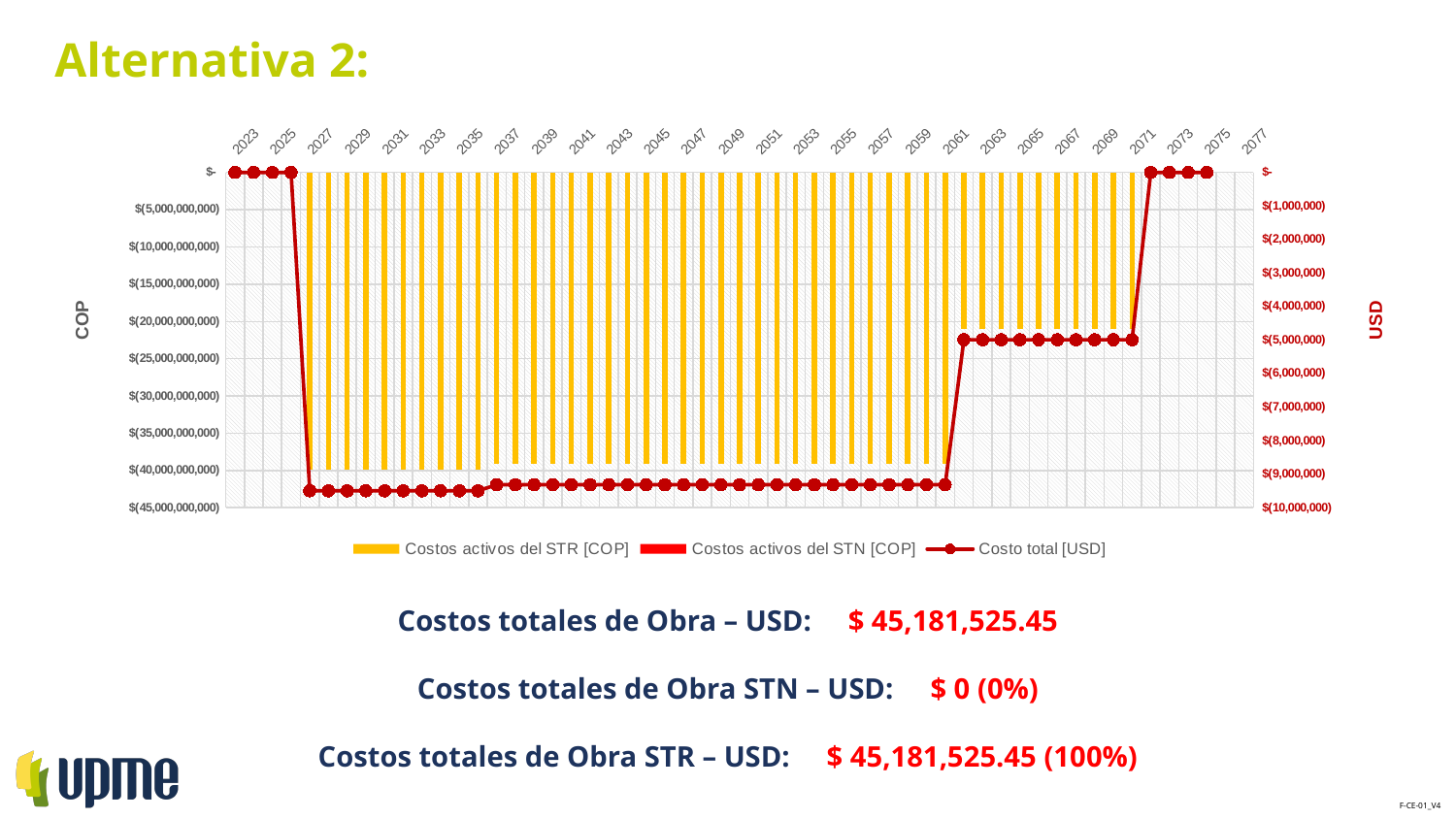
What is the title of the left vertical axis of the chart? COP What is the value of Costo total [USD] in 2023? $- Is the value of Costo total [USD] in 2065 greater or less than $(4,000,000)? less Is the value of Costo total [USD] in 2031 greater or less than $(9,000,000)? less Which series is drawn as a line with markers in the chart? Costo total [USD] Which is higher on the USD axis, the Costo total [USD] value in 2065 or in 2045? 2065 Is the value of Costos activos del STR [COP] in 2045 greater or less than $(35,000,000,000)? less What is the value of Costo total [USD] in 2075? $- How many series does the chart legend list? 3 How many year labels are shown along the x axis of the chart? 28 Does the Costo total [USD] line rise or fall between 2059 and 2061? Neither; it stays flat (the rise comes after 2061) What kind of chart is shown on the slide? A combined bar and line chart